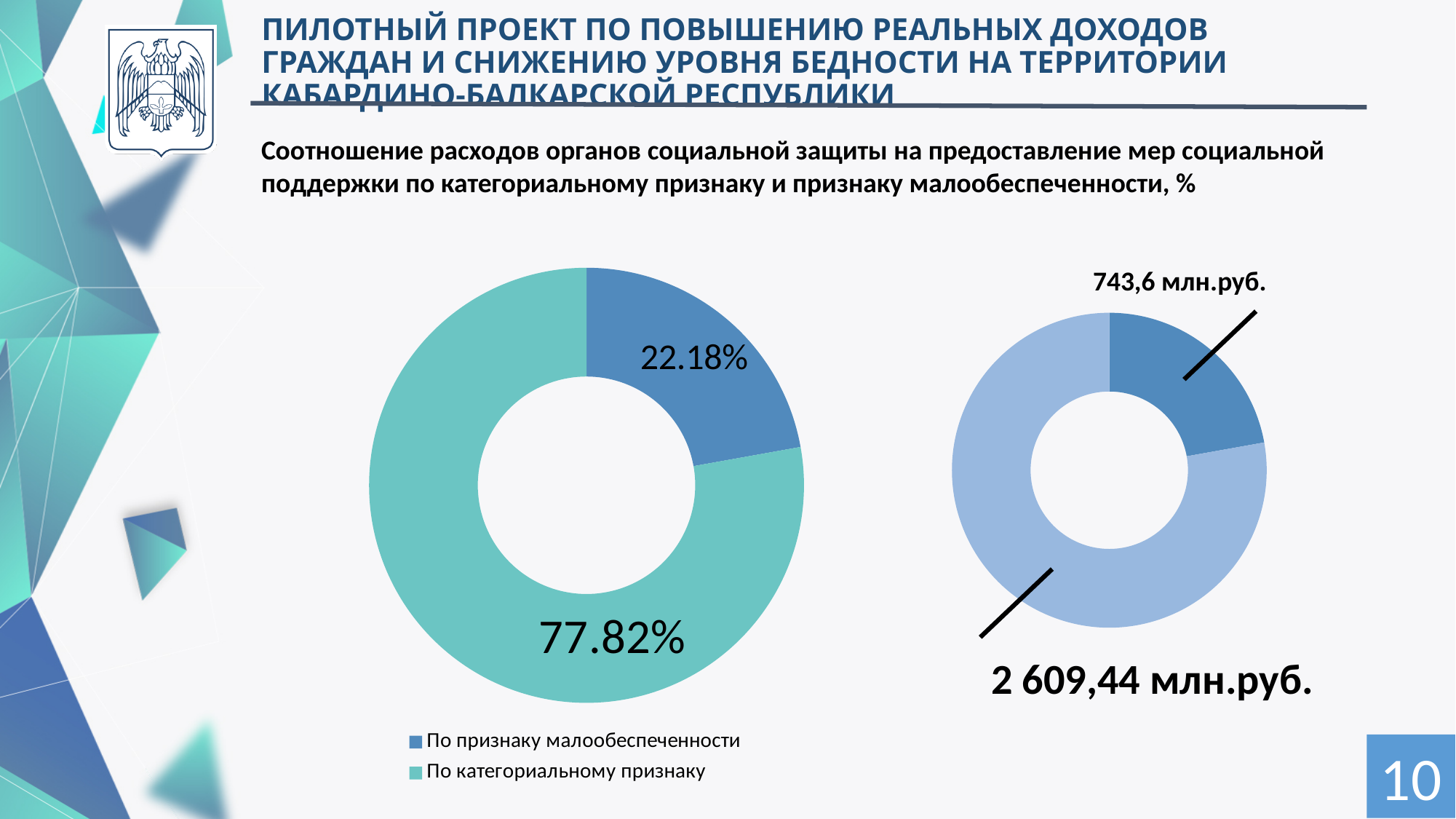
In the left donut chart, what is the difference in percentage points between 'По категориальному признаку' and 'По признаку малообеспеченности'? 55.64 In the left donut chart, what percentage is shown for 'По категориальному признаку'? 77.82% In the left donut chart, what percentage is shown for 'По признаку малообеспеченности'? 22.18% In the left donut chart, which colour represents 'По признаку малообеспеченности'? Blue How many categories does the legend of the left donut chart list? 2 In the left donut chart, which is larger: the share for 'По признаку малообеспеченности' or the share for 'По категориальному признаку'? По категориальному признаку In the left donut chart, which category has the smallest share? По признаку малообеспеченности In the right donut chart, what value is labelled for the light blue segment on the left? 2 609,44 млн.руб. In the right donut chart, what value is labelled for the dark blue segment at the top right? 743,6 млн.руб. What type of chart is the chart on the left of the slide? Pie (donut) chart In the left donut chart, what share of the whole does the teal slice represent? 77.82% In the left donut chart, which category has the largest share? По категориальному признаку